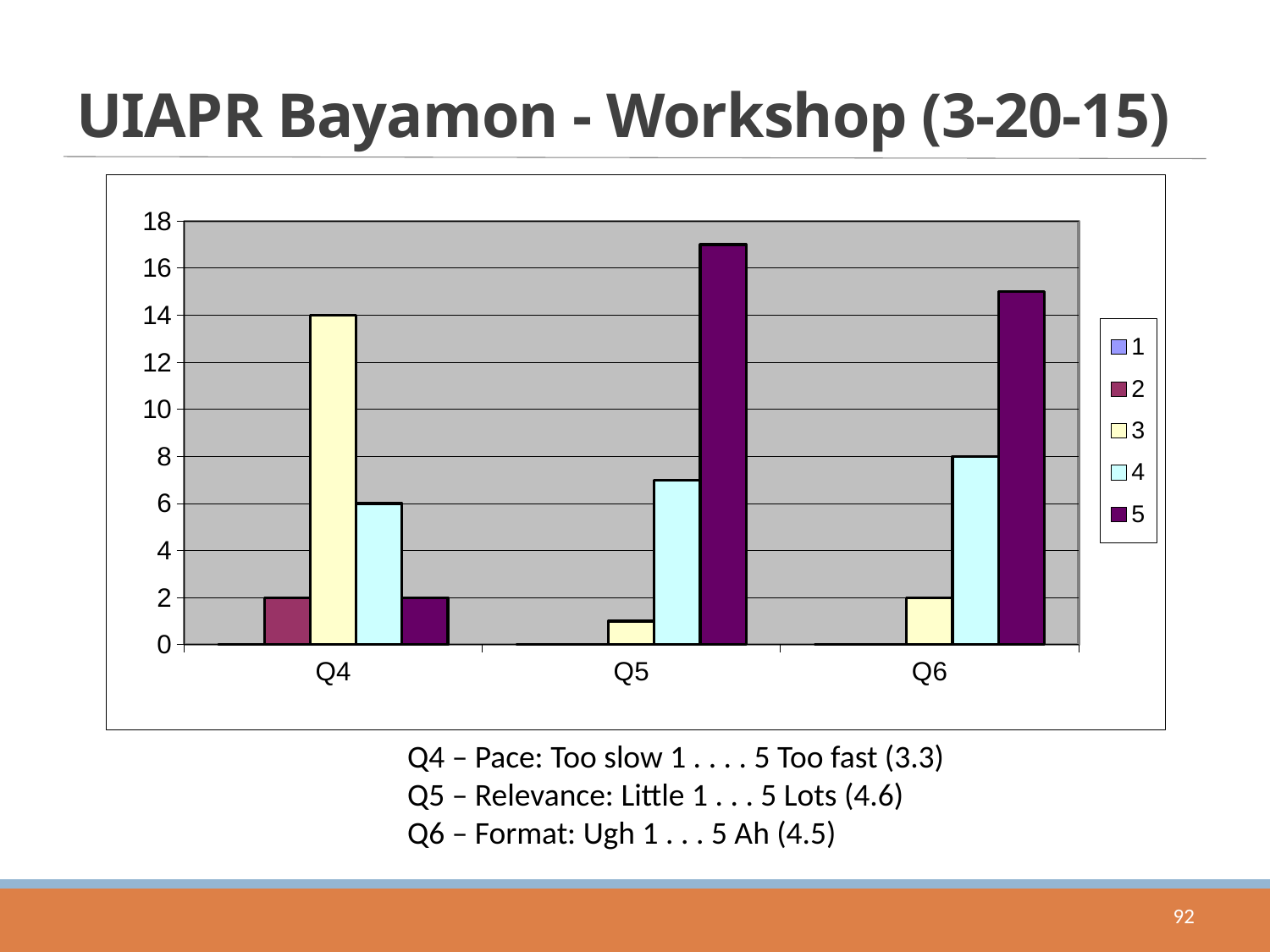
What is the value for series 3 in category Q4? 14 What is the value for series 4 in category Q6? 8 Is the value for series 5 in category Q6 greater or less than 14? greater What is the value for series 4 in category Q4? 6 Which series has the highest value in category Q5? 5 What is the difference between series 3 and series 4 in category Q4? 8 Is the value for series 5 in category Q5 greater or less than 16? greater Which is larger: series 5 in Q5 or series 5 in Q6? series 5 in Q5 How many categories are shown on the x axis? 3 What kind of chart is shown on the slide? bar chart Which series has the highest value in category Q4? 3 How many series does the legend list? 5